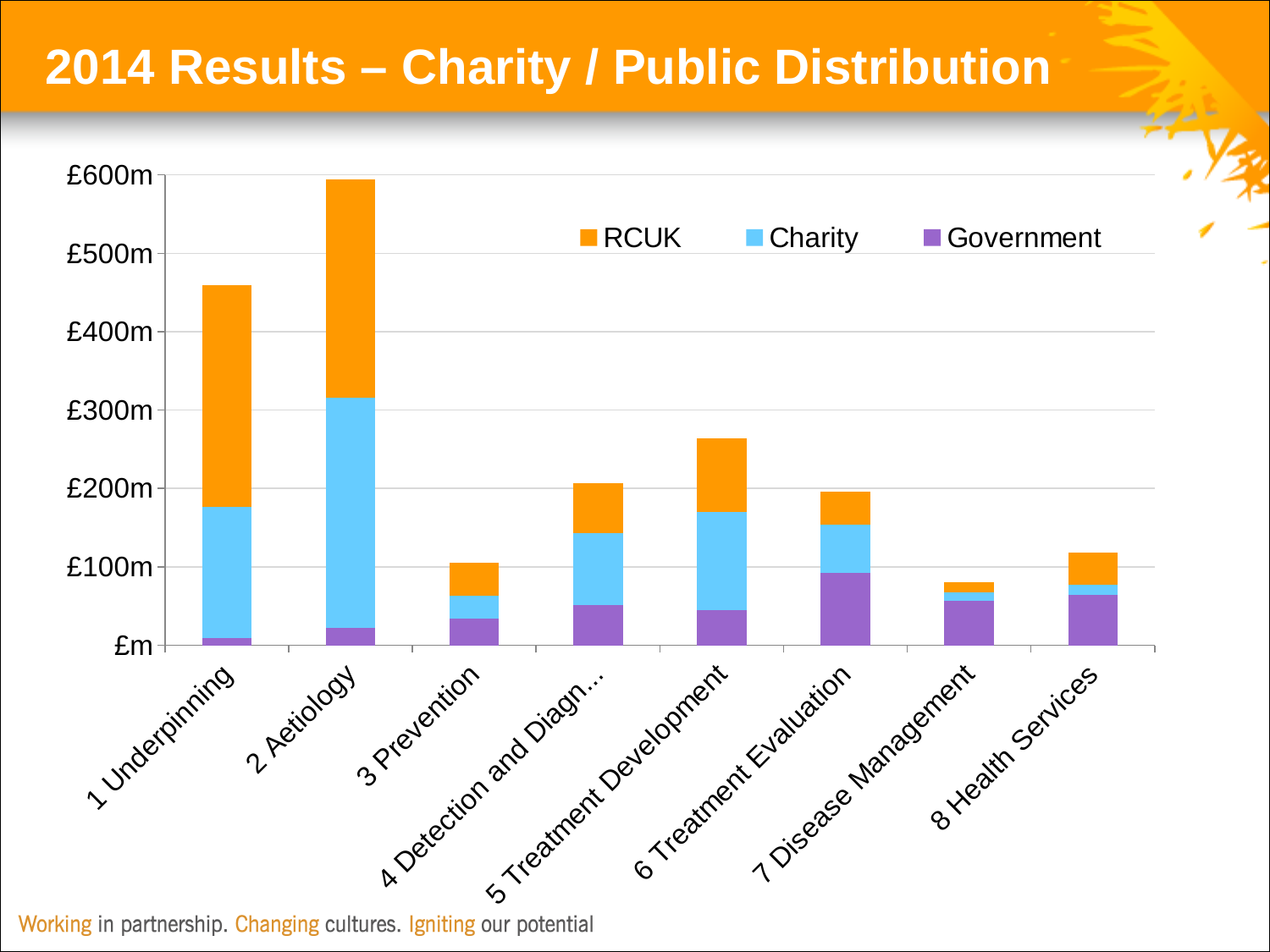
Is the total value for 5 Treatment Development greater or less than £200m? greater Which has the larger total bar, 1 Underpinning or 5 Treatment Development? 1 Underpinning How many series does the chart's legend list? 3 Is the total value for 2 Aetiology greater or less than £500m? greater Which series is shown in orange in the chart's legend? RCUK How many categories are shown on the x axis of the chart? 8 Which category has the highest total bar? 2 Aetiology Is the total value for 1 Underpinning greater or less than £400m? greater What kind of chart is shown on the slide? Stacked bar chart Which category has the lowest total bar? 7 Disease Management Which category has the larger Government segment, 1 Underpinning or 6 Treatment Evaluation? 6 Treatment Evaluation